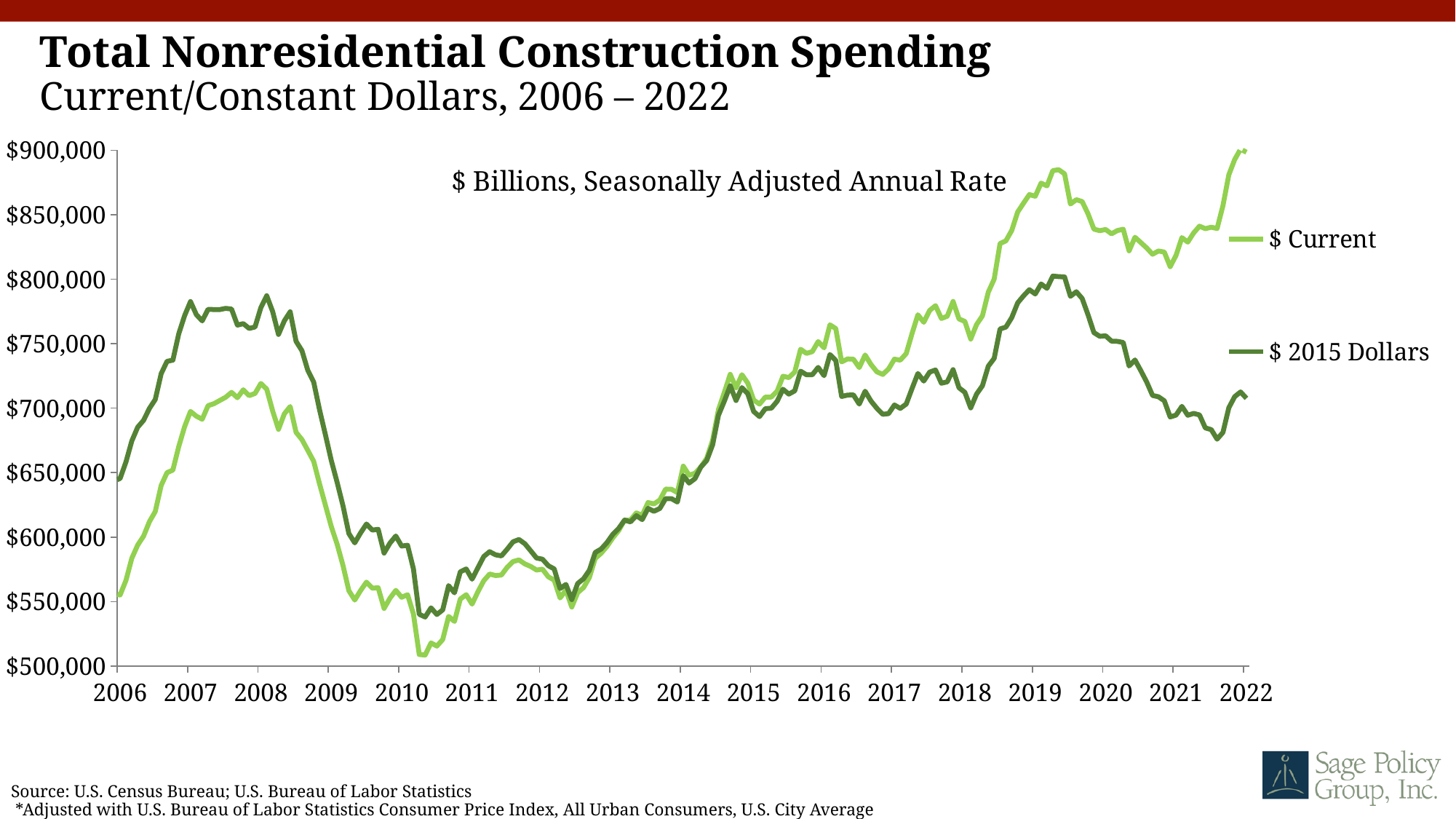
Is the value for $ Current at the start of 2006 greater or less than $600,000? less Is the value for $ 2015 Dollars at 2019 greater or less than $750,000? greater Does the $ 2015 Dollars series rise or fall between 2019 and 2021? fall Is the value for $ Current at 2022 greater or less than $850,000? greater In which year does the $ Current series reach its highest point? 2022 At the start of 2006, which series is higher, $ Current or $ 2015 Dollars? $ 2015 Dollars How many series does the legend list? 2 What kind of chart is shown on the slide? line chart What are the two series named in the legend? $ Current and $ 2015 Dollars At 2022, which series is higher, $ Current or $ 2015 Dollars? $ Current